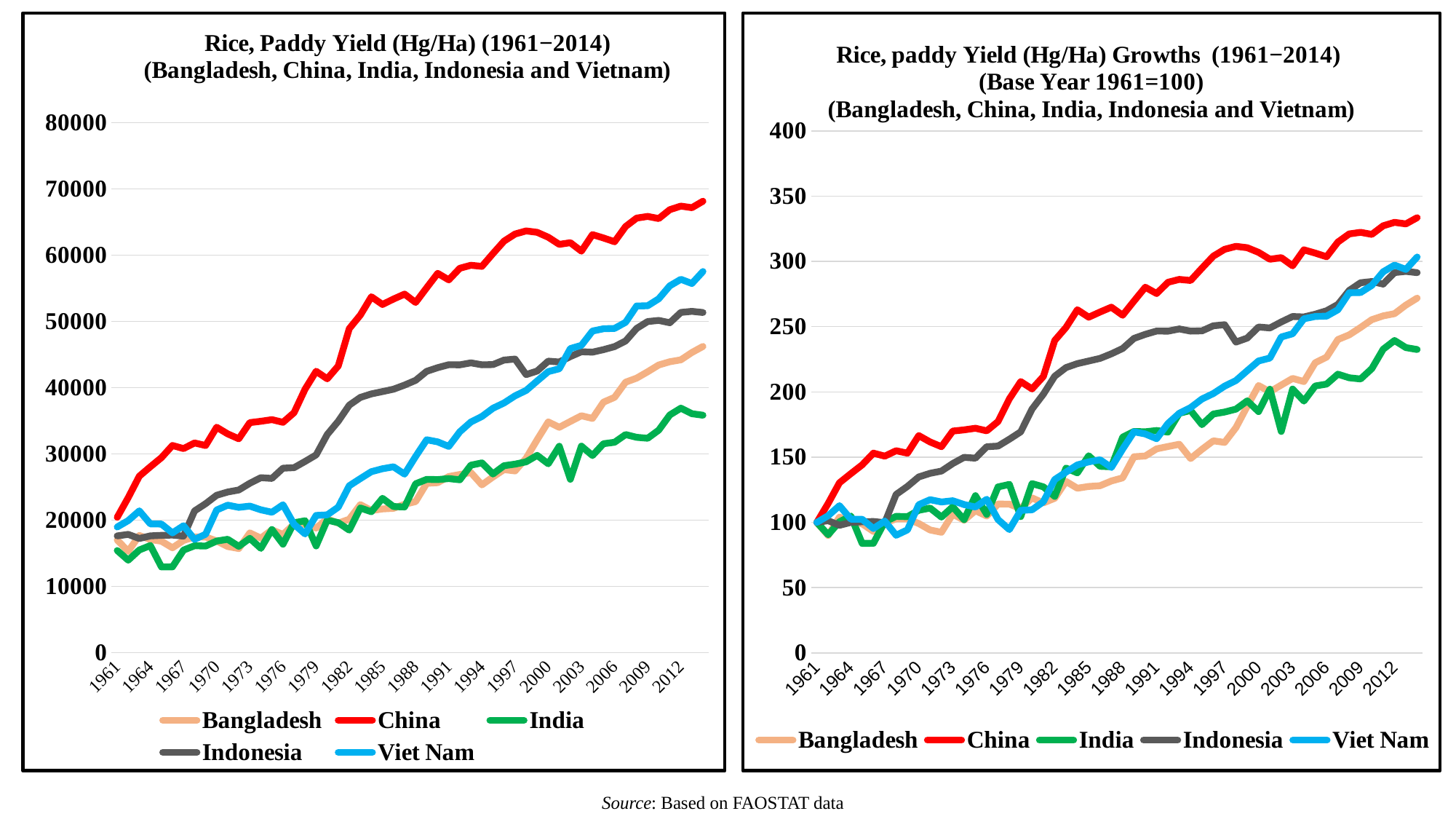
How many series does the legend of the left chart list? 5 In the right chart, which country has the lowest growth index in 2014? India In the left chart, does China's rice paddy yield generally rise or fall from 1961 to 2014? Rise In the right chart, what is the base year index value for all countries in 1961? 100 In the right chart, is the value for China in 2014 greater or less than 300? greater In the right chart, 'Rice, paddy Yield (Hg/Ha) Growths', which country has the highest growth index in 2014? China In the left chart, which country has the lowest rice paddy yield in 2014? India In the left chart, which country has the highest rice paddy yield in 2014? China In the left chart, is the value for India in 2014 greater or less than 40000? less In the left chart, is the value for China in 2014 greater or less than 60000? greater What type of chart is the left chart, 'Rice, Paddy Yield (Hg/Ha) (1961-2014)'? Line chart In the left chart, which is larger in 2014: the yield for Viet Nam or the yield for Indonesia? Viet Nam